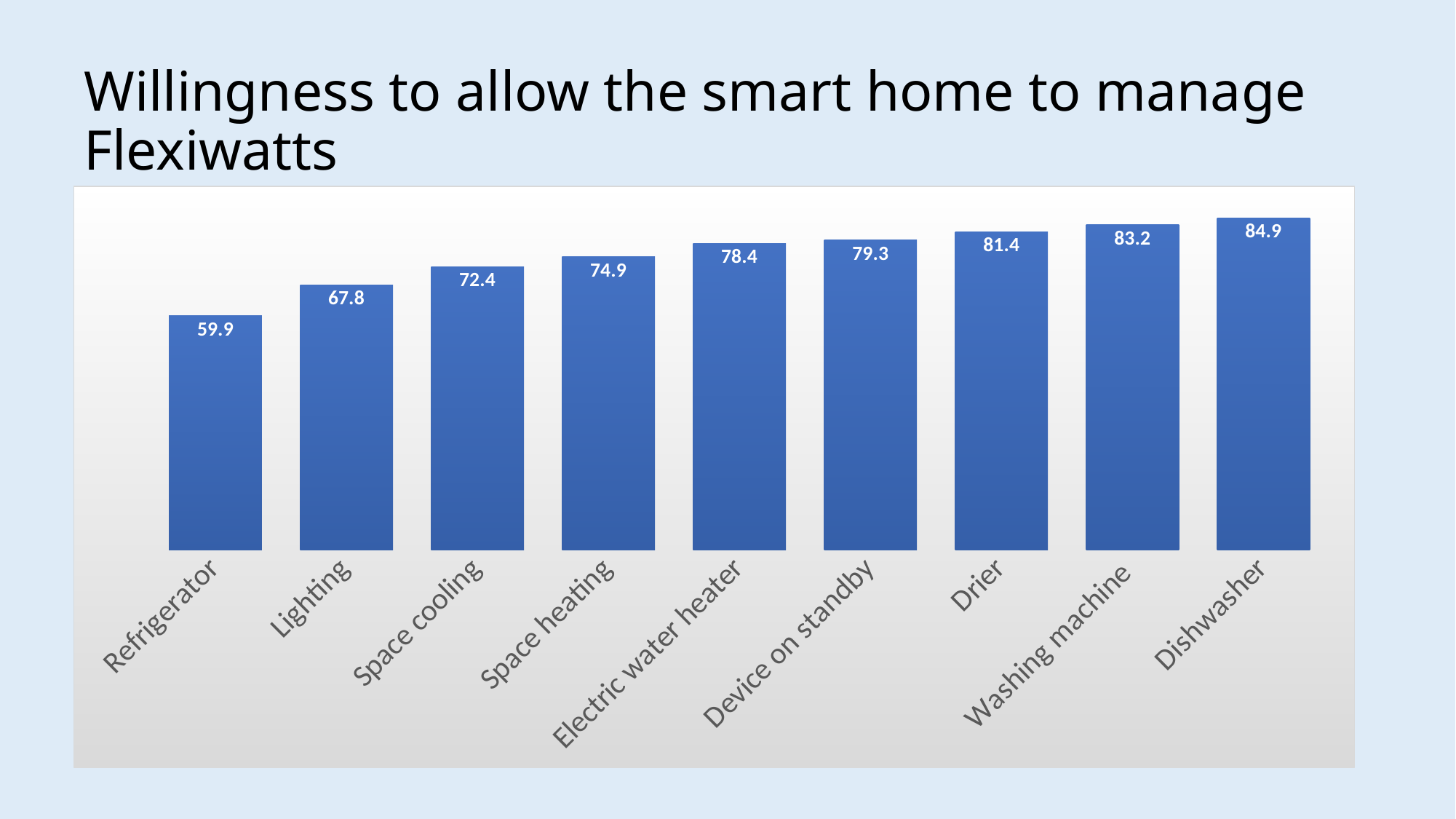
How many categories are shown in the chart? 9 What is the value for Refrigerator? 59.9 Which category has the lowest value? Refrigerator What is the difference between the values for Dishwasher and Refrigerator? 25.0 What is the value for Washing machine? 83.2 What kind of chart is shown on the slide? Bar chart What is the value for Electric water heater? 78.4 Which is larger, the value for Lighting or the value for Space cooling? Space cooling What is the title of the slide? Willingness to allow the smart home to manage Flexiwatts What is the difference between the values for Drier and Space heating? 6.5 Do the values rise or fall from left to right along the x axis? Rise Which category has the highest value? Dishwasher